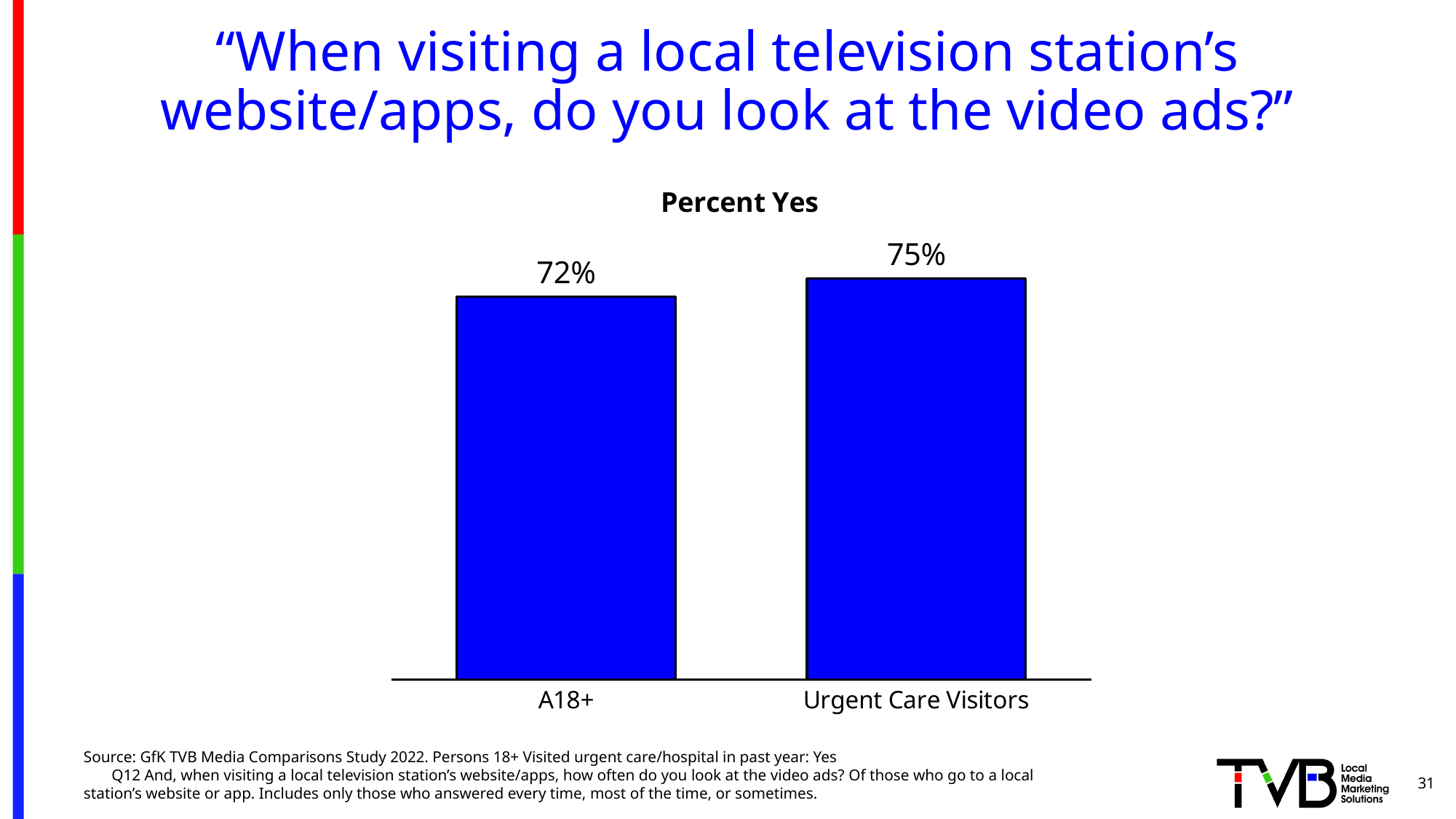
How many categories are shown on the chart? 2 What kind of chart is shown on the slide? bar chart Is the value for Urgent Care Visitors larger or smaller than the value for A18+? larger What is the Percent Yes value for A18+? 72% Which category has the higher Percent Yes value? Urgent Care Visitors What is the Percent Yes value for Urgent Care Visitors? 75% Which category has the lower Percent Yes value? A18+ What is the title of the chart? Percent Yes What colour are the bars in the chart? blue What is the difference in percentage points between Urgent Care Visitors and A18+? 3 percentage points